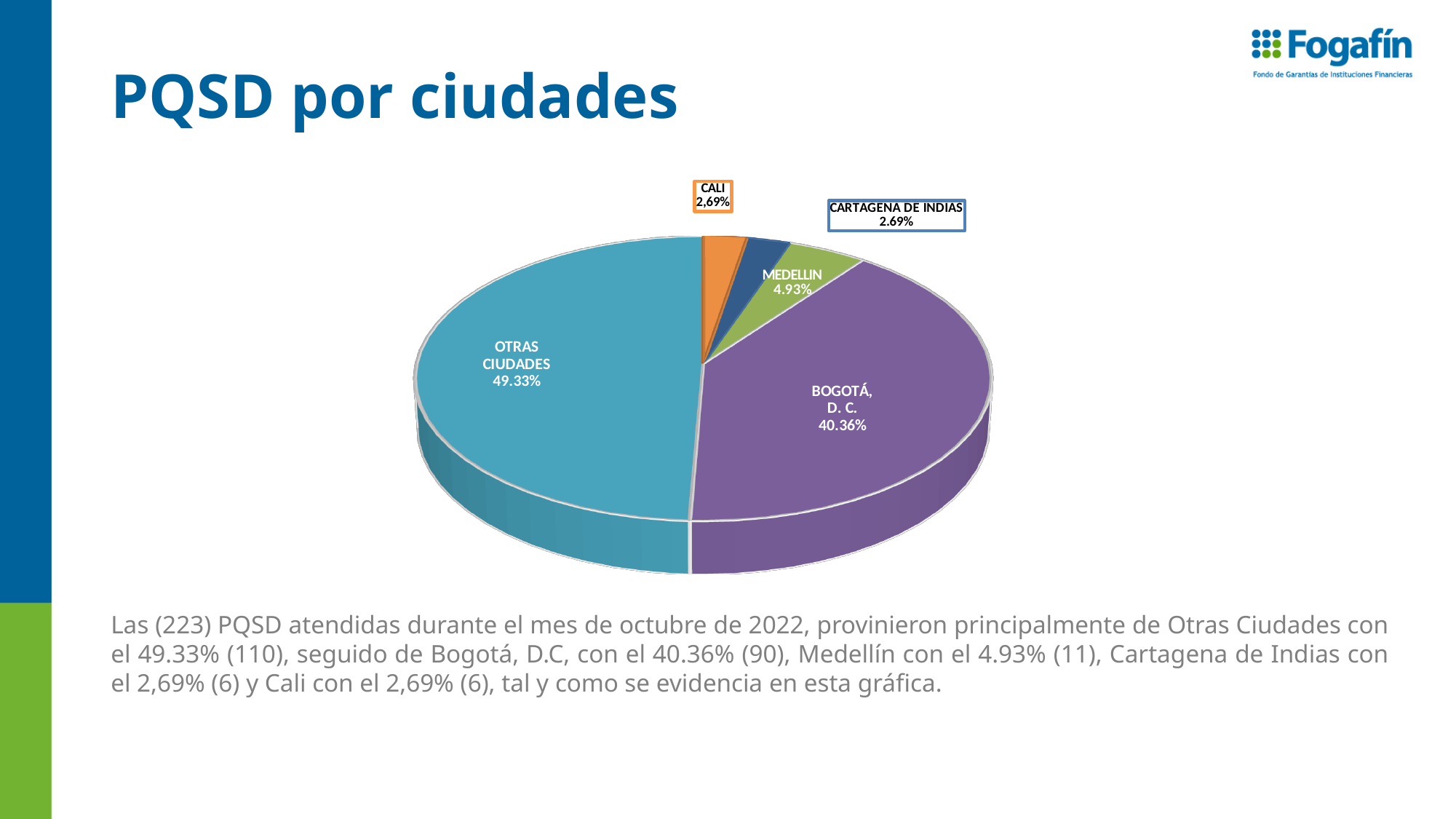
What percentage of PQSD came from Cartagena de Indias? 2.69% What percentage of PQSD came from Medellín? 4.93% What is the difference in percentage points between Bogotá, D. C. and Medellín? 35.43 What percentage of PQSD came from Otras Ciudades? 49.33% What percentage of PQSD came from Cali? 2,69% How many slices does the pie chart have? 5 What is the title of the slide containing the pie chart? PQSD por ciudades What percentage of PQSD came from Bogotá, D. C.? 40.36% What is the difference in percentage points between Otras Ciudades and Bogotá, D. C.? 8.97 What kind of chart is shown on the slide? Pie chart Which city category has the largest share of the pie? Otras Ciudades Which has a larger share, Otras Ciudades or Bogotá, D. C.? Otras Ciudades